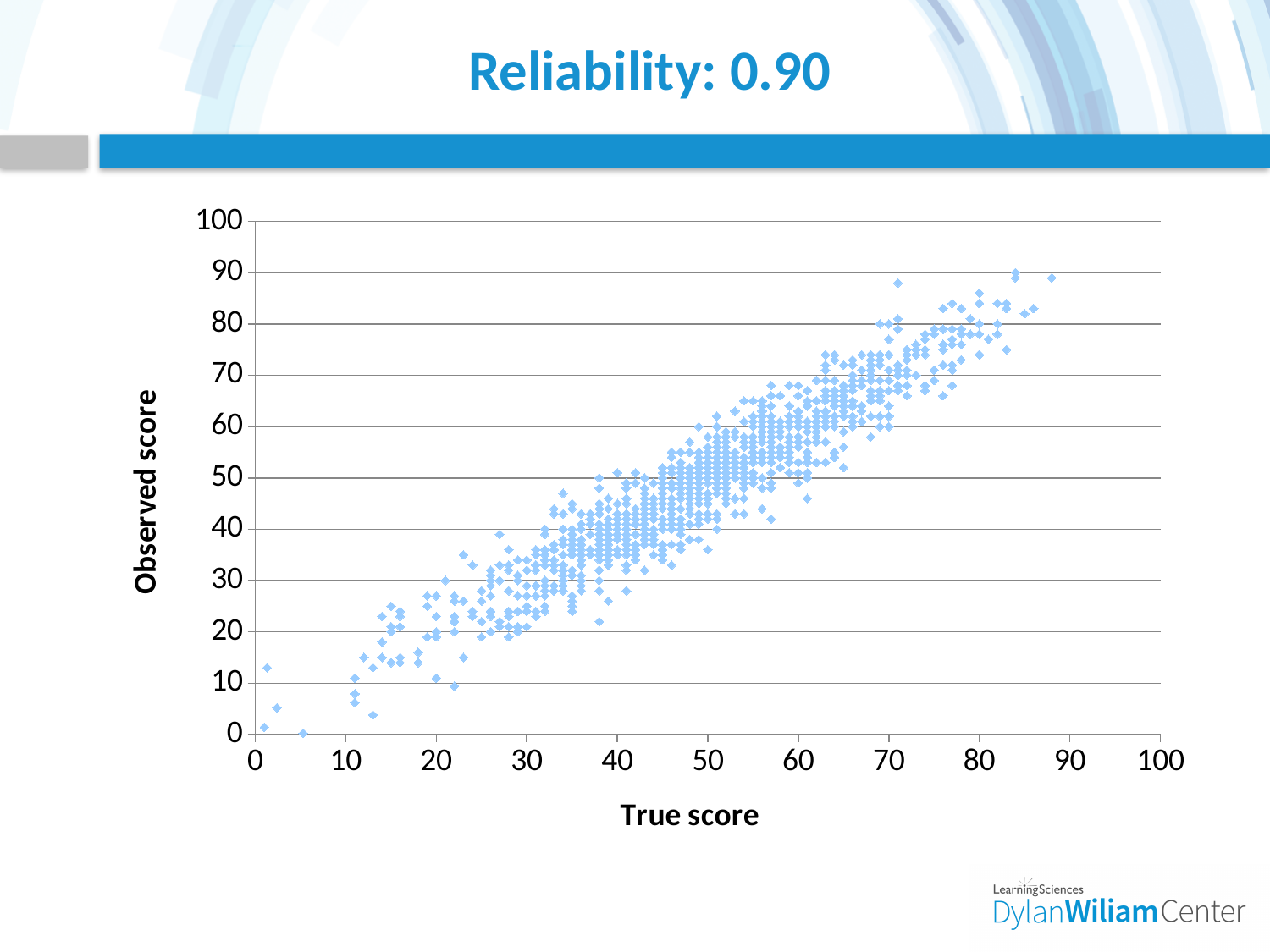
What kind of chart is shown on the slide? scatter plot What is the label on the x axis? True score Are any points plotted with an observed score above 90? no As the true score increases along the x axis, do the observed scores generally rise or fall? rise What is the maximum value shown on the y axis? 100 Is the observed score of the point with the highest true score greater or less than 80? greater Is the observed score of the point with the lowest true score greater or less than 20? less What is the title of the chart? Reliability: 0.90